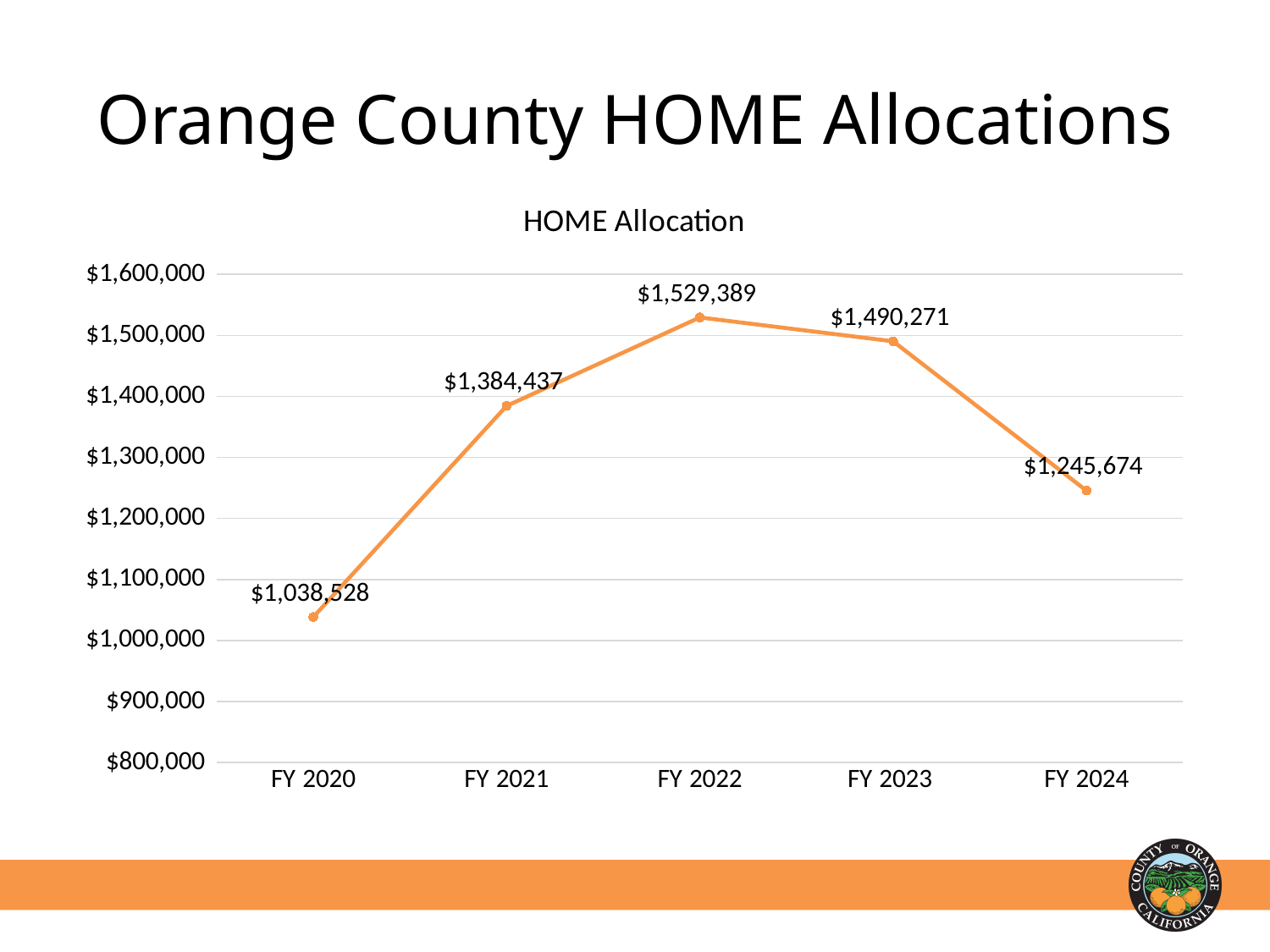
What kind of chart is shown on the slide? line chart How many fiscal years are plotted on the chart? 5 By how much did the HOME allocation increase from FY 2020 to FY 2021? $345,909 Does the HOME allocation rise or fall from FY 2022 to FY 2024? fall What is the HOME allocation for FY 2020? $1,038,528 Which fiscal year has the highest HOME allocation? FY 2022 What is the difference between the FY 2022 and FY 2023 HOME allocations? $39,118 What is the HOME allocation for FY 2024? $1,245,674 Which fiscal year has the lowest HOME allocation? FY 2020 What is the HOME allocation for FY 2022? $1,529,389 Is the HOME allocation for FY 2023 greater or less than $1,400,000? greater Which is larger, the HOME allocation for FY 2021 or for FY 2024? FY 2021